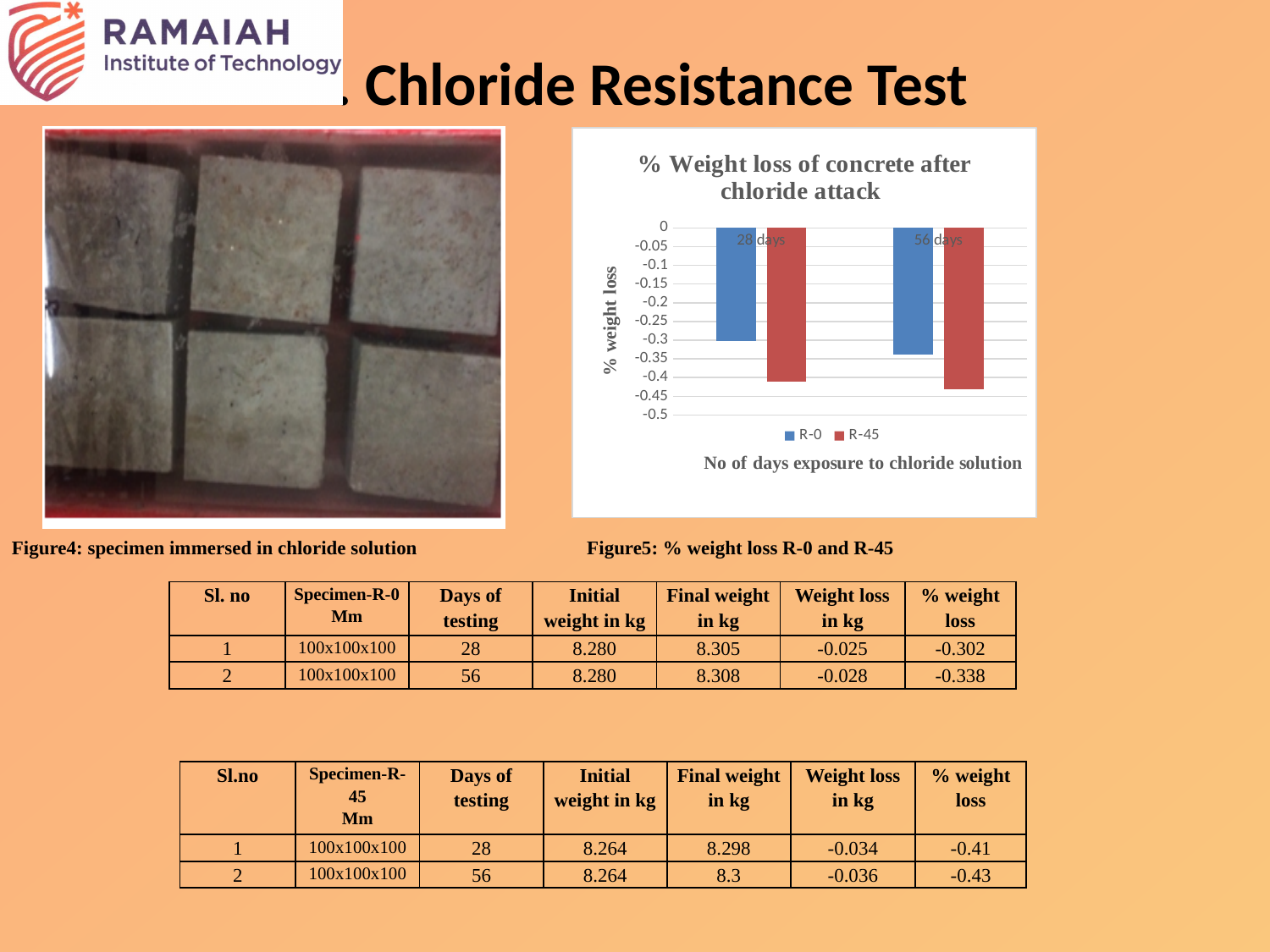
What is the title of the chart on the right of the slide? % Weight loss of concrete after chloride attack What kind of chart is shown in Figure5 (% Weight loss of concrete after chloride attack)? bar chart In the weight loss chart, is the value for R-45 at 28 days greater or less than -0.35? less In the weight loss chart, is the value for R-0 at 28 days greater or less than -0.25? less In the weight loss chart, is the value for R-0 at 56 days greater or less than -0.4? greater In the weight loss chart, do the R-45 values rise or fall from 28 days to 56 days? fall In the weight loss chart, which series has the higher (less negative) value at 28 days, R-0 or R-45? R-0 What are the two series named in the legend of the weight loss chart? R-0 and R-45 How many series does the legend of the weight loss chart list? 2 In the weight loss chart, which bar shows the lowest (most negative) % weight loss? R-45 at 56 days How many exposure-day categories are shown on the x axis of the weight loss chart? 2